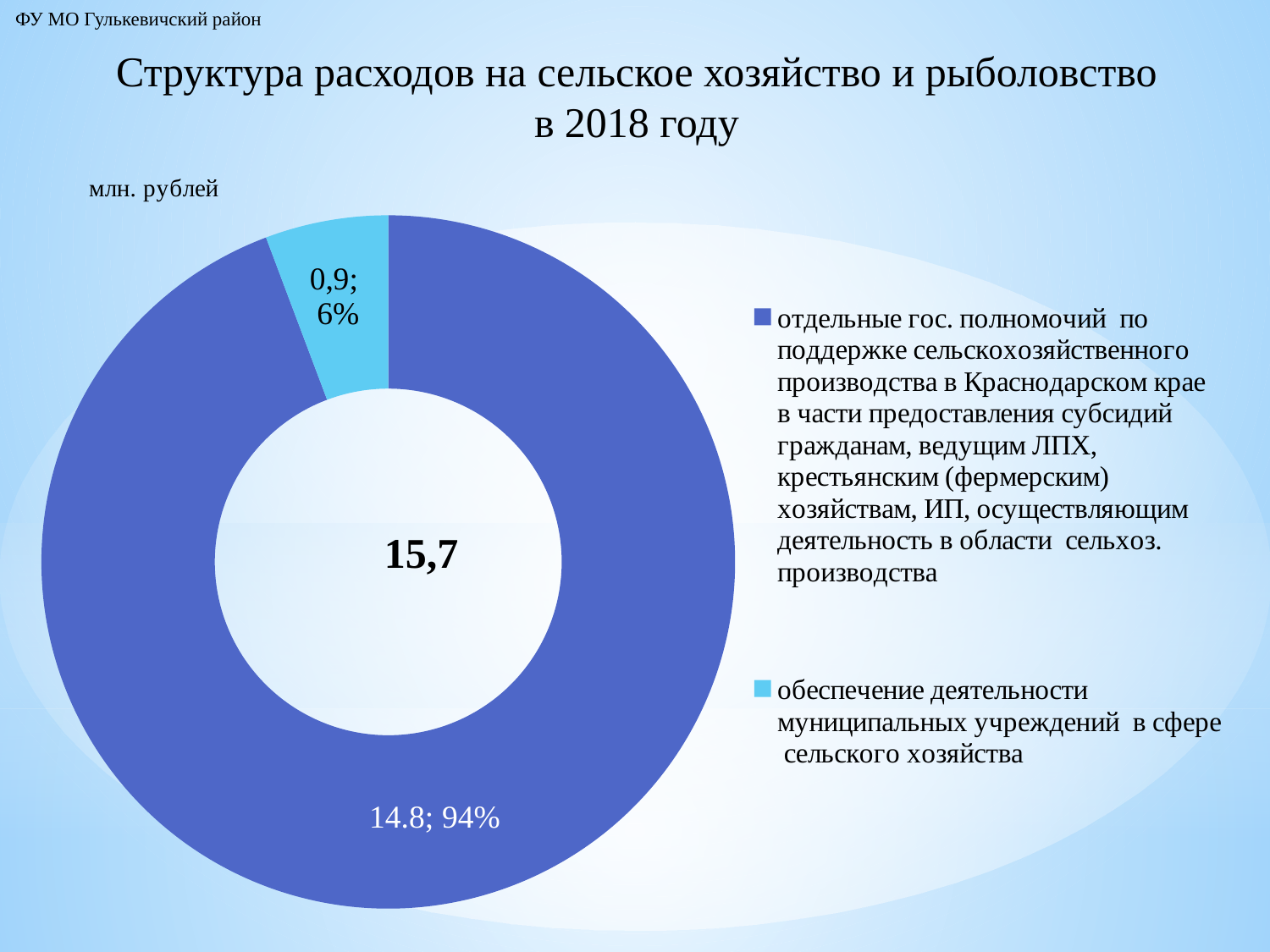
What is the value shown for the slice 'отдельные гос. полномочий по поддержке сельскохозяйственного производства в Краснодарском крае...'? 14.8 What kind of chart is shown on the slide? Doughnut (pie) chart How many entries does the legend list? 2 Which category has the largest slice? отдельные гос. полномочий по поддержке сельскохозяйственного производства в Краснодарском крае... What share of the chart does the slice for 'отдельные гос. полномочий по поддержке сельскохозяйственного производства...' represent? 94% What share of the chart does 'обеспечение деятельности муниципальных учреждений в сфере сельского хозяйства' represent? 6% How many slices does the chart have? 2 What colour is the slice for 'обеспечение деятельности муниципальных учреждений в сфере сельского хозяйства'? Light blue What is the value shown for 'обеспечение деятельности муниципальных учреждений в сфере сельского хозяйства'? 0,9 What total value is shown in the centre of the chart? 15,7 Which category has the smallest slice? обеспечение деятельности муниципальных учреждений в сфере сельского хозяйства What unit of measurement is indicated for the chart? млн. рублей